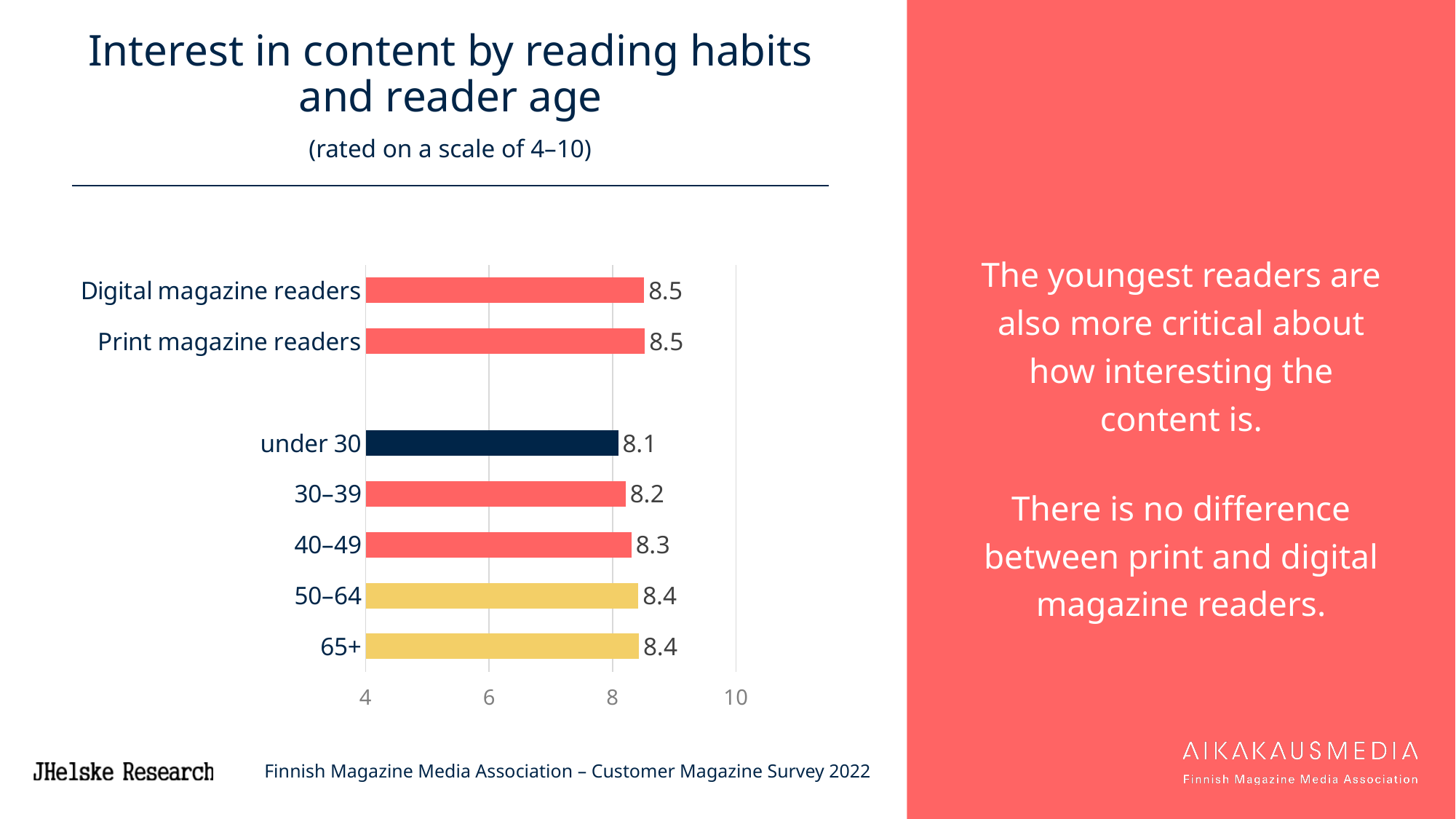
What is the value for the 40–49 age group? 8.3 Is the value for the 30–39 age group greater or less than 8? greater What is the value for the 65+ age group? 8.4 How many bars are shown in the chart? 7 What kind of chart is shown on the slide? bar chart Which is larger, the value for 40–49 or the value for under 30? 40–49 Which age group has the lowest rating? under 30 What is the value for the under 30 age group? 8.1 What is the difference between the 50–64 and 30–39 age groups? 0.2 What is the value for Digital magazine readers? 8.5 What scale are the ratings based on, according to the subtitle? 4–10 What is the difference between the value for Print magazine readers and the value for under 30? 0.4